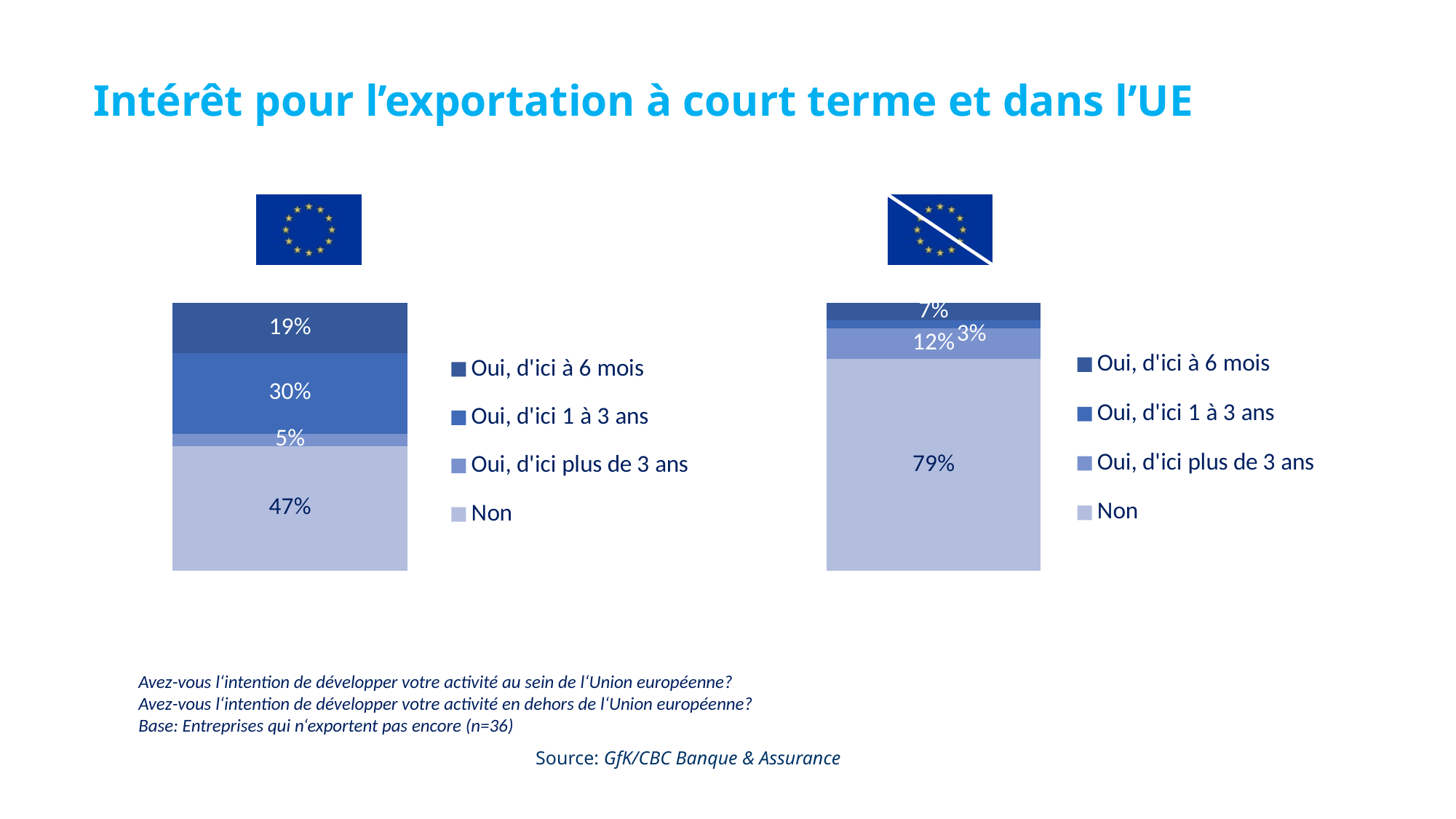
What type of chart is used on this slide? Stacked bar chart In the right chart (crossed-out EU flag), what percentage answered "Oui, d'ici plus de 3 ans"? 12% What is the difference between the "Non" share in the right chart and the "Non" share in the left chart? 32 percentage points In the left chart (EU flag), which response has the smallest share? Oui, d'ici plus de 3 ans Which is larger: "Oui, d'ici 1 à 3 ans" in the left chart or "Oui, d'ici 1 à 3 ans" in the right chart? Left chart (30%) In the left chart (EU flag), what percentage of respondents answered "Non"? 47% What is the total of the segments in the left chart (EU flag)? 101% In the left chart (EU flag), what percentage answered "Oui, d'ici 1 à 3 ans"? 30% In the left chart (EU flag), what percentage answered "Oui, d'ici à 6 mois"? 19% In the right chart (crossed-out EU flag), which response has the largest share? Non How many entries does the legend of the left chart list? 4 In the right chart (crossed-out EU flag), what percentage answered "Non"? 79%